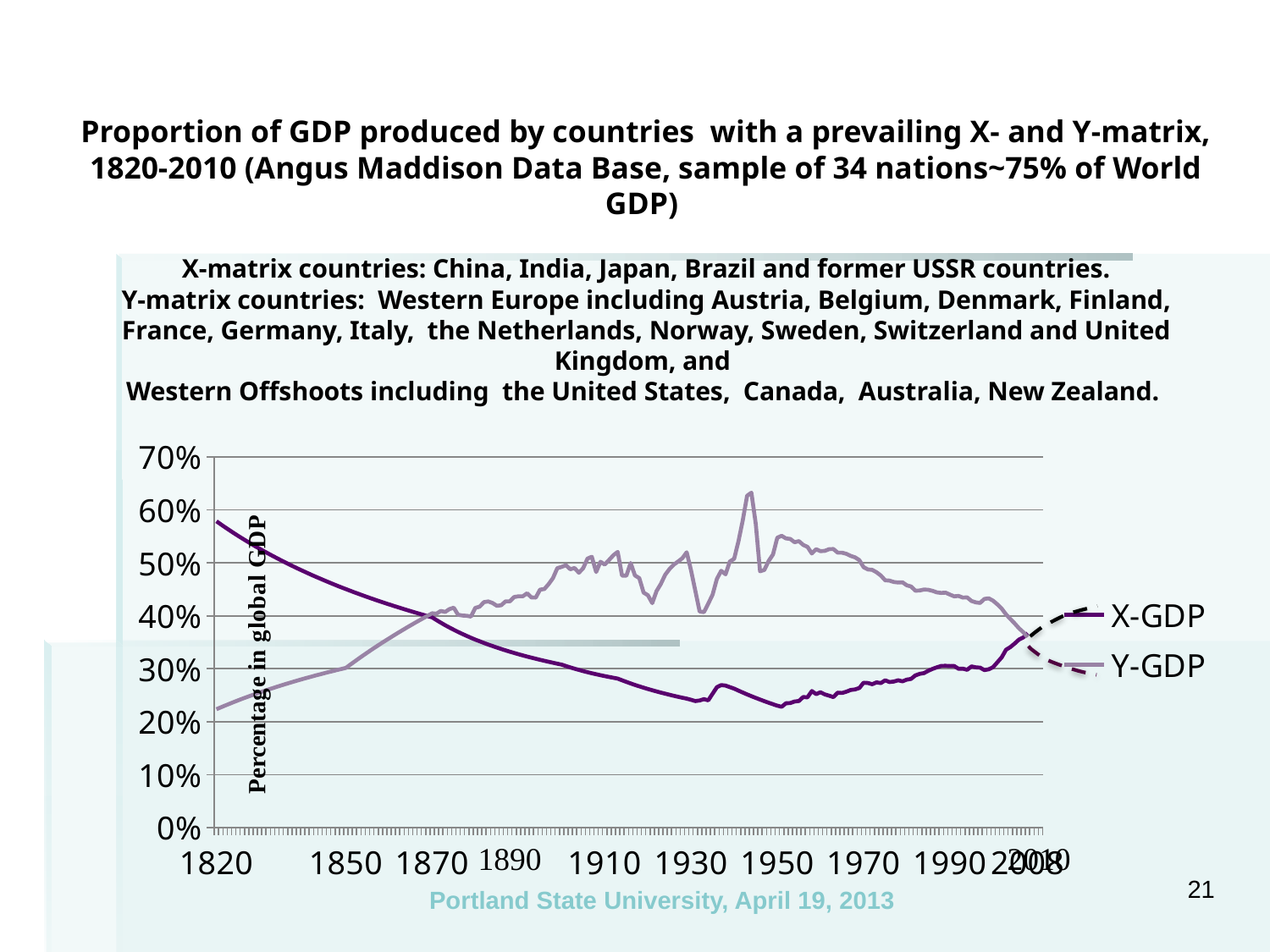
Which series has the higher value in 1820, X-GDP or Y-GDP? X-GDP What kind of chart is shown on the slide? line chart How many series does the chart's legend list? 2 What is the label on the vertical axis of the chart? Percentage in global GDP What are the two series named in the legend? X-GDP and Y-GDP Is the value for X-GDP in 1950 greater or less than 30%? less Which series has the higher value in 1910, X-GDP or Y-GDP? Y-GDP Is the value for Y-GDP in 1950 greater or less than 40%? greater Does the X-GDP line rise or fall between 1820 and 1950? fall Is the value for X-GDP in 1820 greater or less than 50%? greater Does the Y-GDP line rise or fall between 1820 and 1870? rise